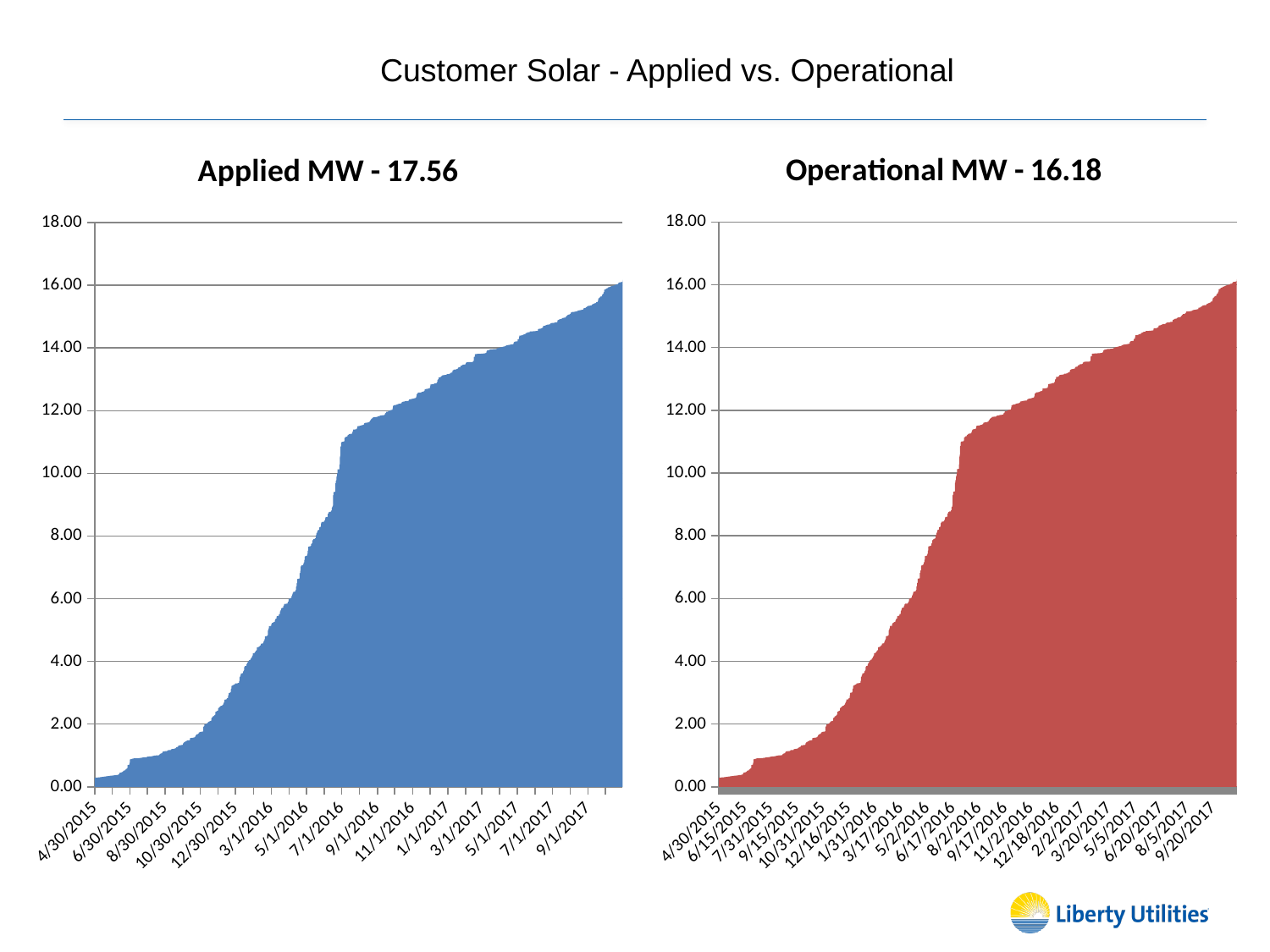
What is the highest value shown on the y axis of the 'Applied MW - 17.56' chart? 18.00 What is the difference between the Applied MW total (17.56) and the Operational MW total (16.18) shown in the chart titles? 1.38 In the 'Operational MW - 16.18' chart, is the value at 3/17/2016 greater or less than 8.00? less In the 'Applied MW - 17.56' chart, do the values rise or fall over time along the x axis? Rise In the 'Applied MW - 17.56' chart, is the value at 3/1/2016 greater or less than 6.00? less What colour is the filled area in the 'Operational MW - 16.18' chart? Red In the 'Applied MW - 17.56' chart, is the value at 1/1/2017 greater or less than 10.00? greater In the 'Operational MW - 16.18' chart, do the values rise or fall over time along the x axis? Rise What kind of chart is the 'Applied MW - 17.56' chart? Area chart